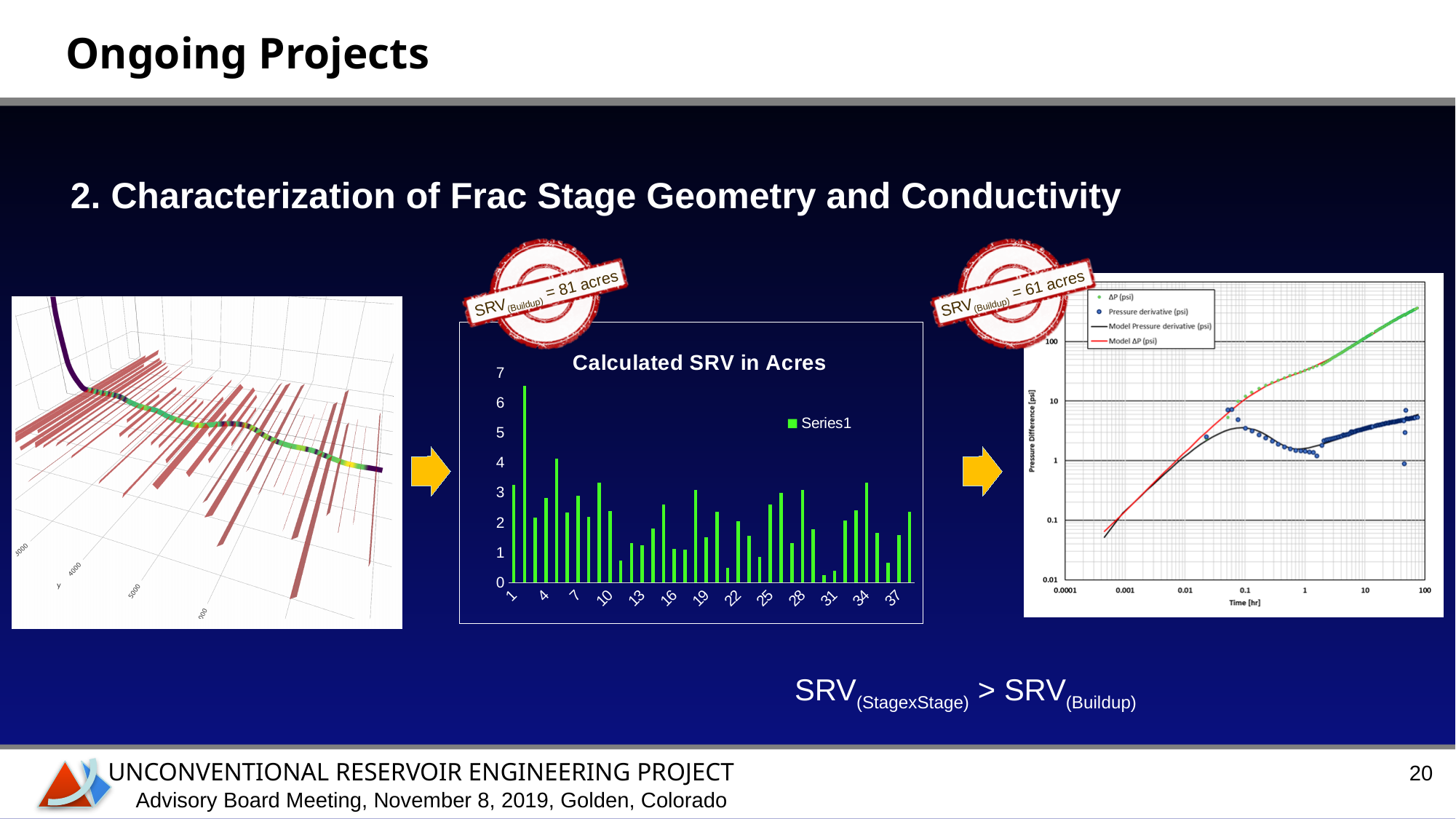
What kind of chart is the 'Calculated SRV in Acres' chart? bar chart How many series does the legend of the 'Calculated SRV in Acres' chart list? 1 In the 'Calculated SRV in Acres' chart, is the value for category 5 greater or less than 3? greater In the 'Calculated SRV in Acres' chart, is the value for category 2 greater or less than 6? greater What is the title of the bar chart in the middle of the slide? Calculated SRV in Acres How many series does the legend of the pressure difference versus time chart on the right list? 4 In the 'Calculated SRV in Acres' chart, which is larger, the value for category 10 or category 11? category 10 In the 'Calculated SRV in Acres' chart, which category has the highest bar? 2 What is the x-axis label of the chart on the right of the slide? Time [hr] In the 'Calculated SRV in Acres' chart, which is larger, the value for category 1 or category 2? category 2 In the 'Calculated SRV in Acres' chart, is the value for category 31 greater or less than 1? less